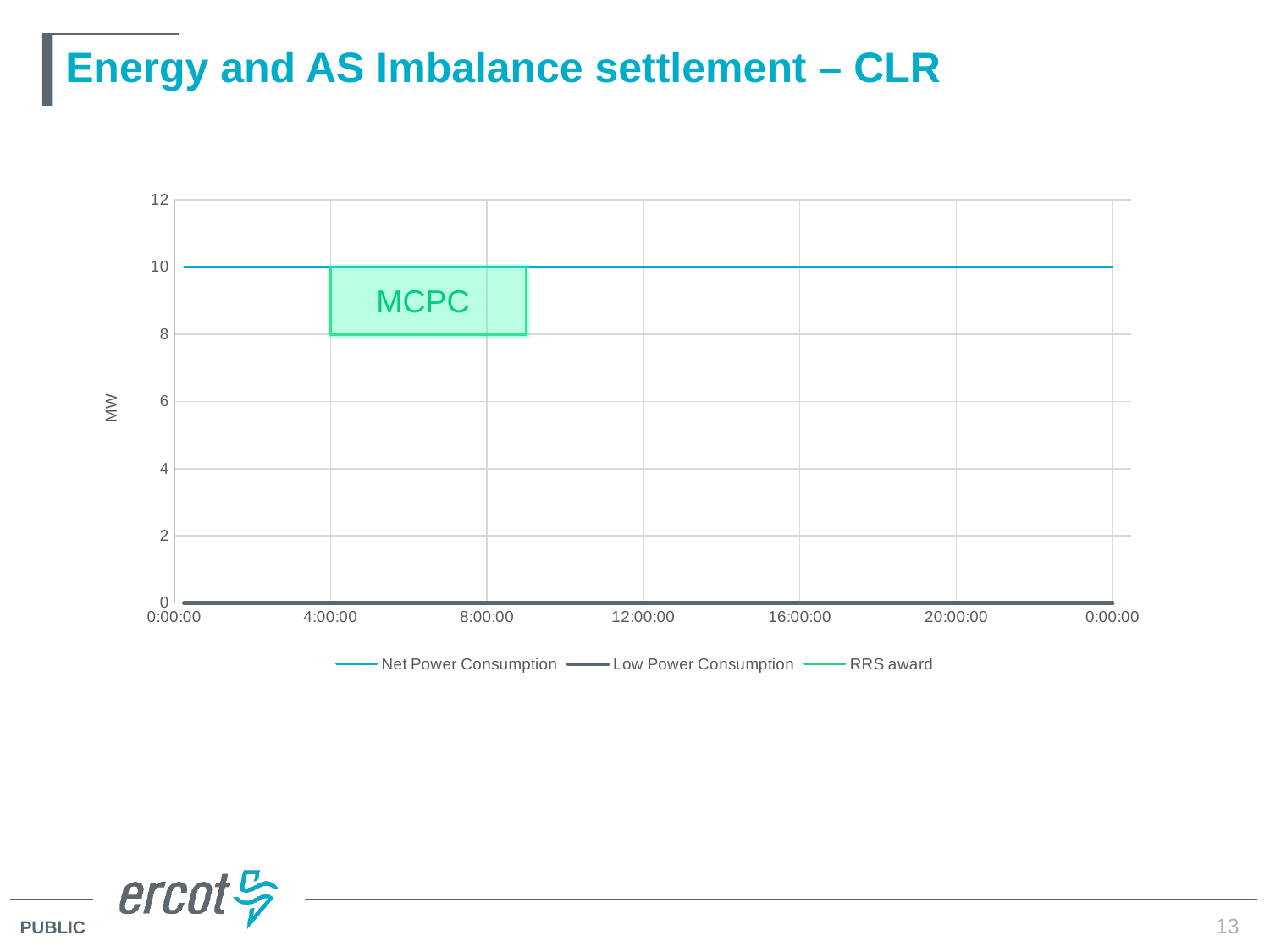
How many series does the legend list? 3 What is the label on the y axis? MW What is the value of Low Power Consumption in MW? 0 What is the value of Net Power Consumption in MW? 10 What is the lower bound in MW of the RRS award box? 8 At what time does the RRS award box begin? 4:00:00 Does Net Power Consumption rise, fall, or stay constant across the day? stays constant What is the difference between Net Power Consumption and Low Power Consumption in MW? 10 What type of chart is shown on the slide? line chart What label is printed inside the green RRS award box? MCPC Is the value for Net Power Consumption greater or less than 6? greater Which is larger, Net Power Consumption or Low Power Consumption? Net Power Consumption